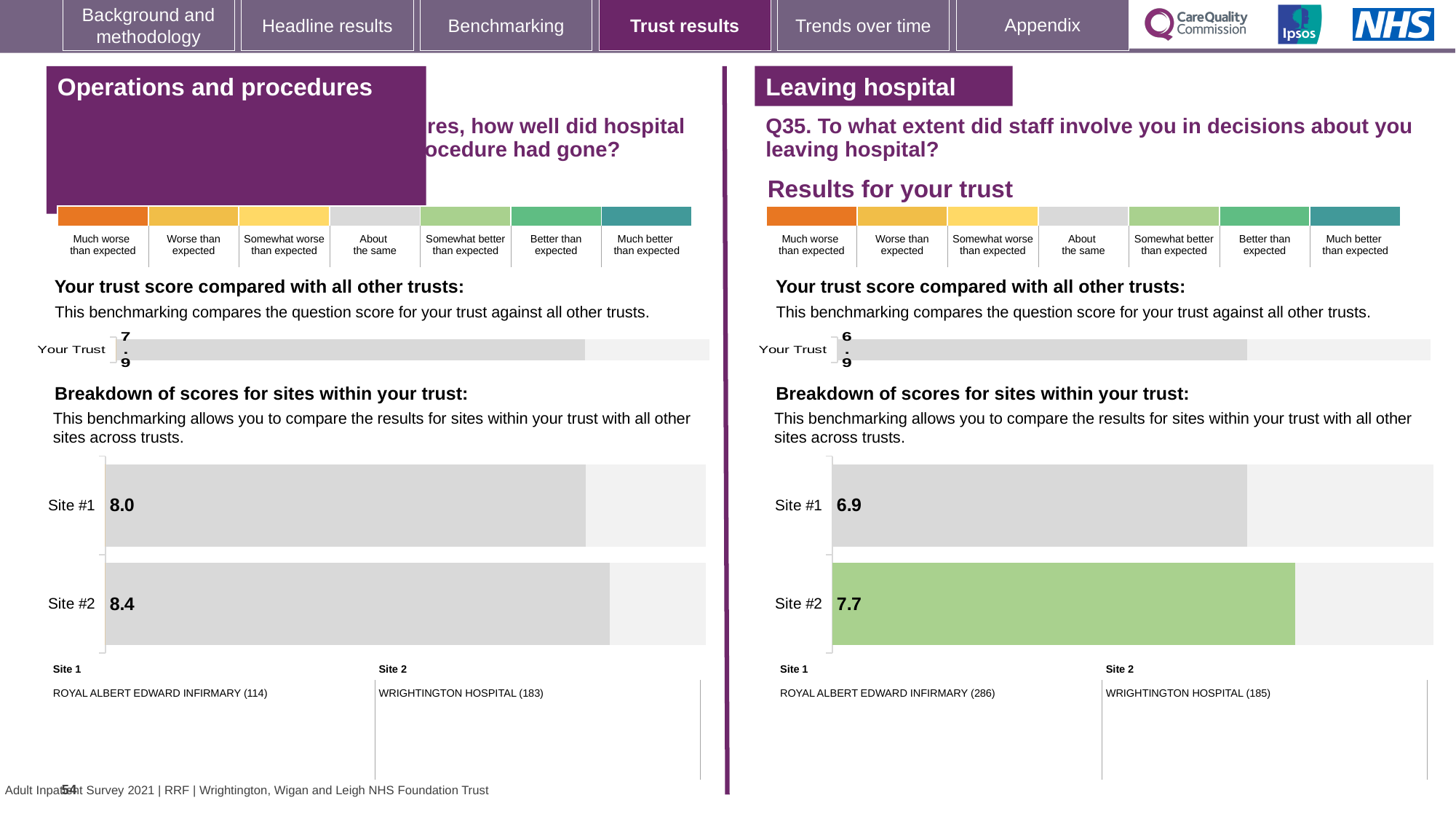
In the Leaving hospital section, what is the 'Your Trust' score in the trust score comparison chart? 6.9 In the Leaving hospital section, what is the score shown for Site #2 in the breakdown of scores for sites chart? 7.7 What type of chart is used for the breakdown of scores for sites in the Operations and procedures section? Bar chart In the Leaving hospital breakdown of scores for sites chart, what is the difference between the Site #2 and Site #1 scores? 0.8 In the Leaving hospital section, what is the score shown for Site #1 in the breakdown of scores for sites chart? 6.9 In the Operations and procedures section, what is the score shown for Site #1 in the breakdown of scores for sites chart? 8.0 In the Leaving hospital breakdown of scores for sites chart, which site has the higher score? Site #2 In the Operations and procedures section, what is the score shown for Site #2 in the breakdown of scores for sites chart? 8.4 How many sites are shown in the Leaving hospital breakdown of scores for sites chart? 2 In the Operations and procedures breakdown of scores for sites chart, what is the difference between the Site #2 and Site #1 scores? 0.4 In the Operations and procedures section, what is the 'Your Trust' score in the trust score comparison chart? 7.9 In the Operations and procedures breakdown of scores for sites chart, which site has the lower score? Site #1